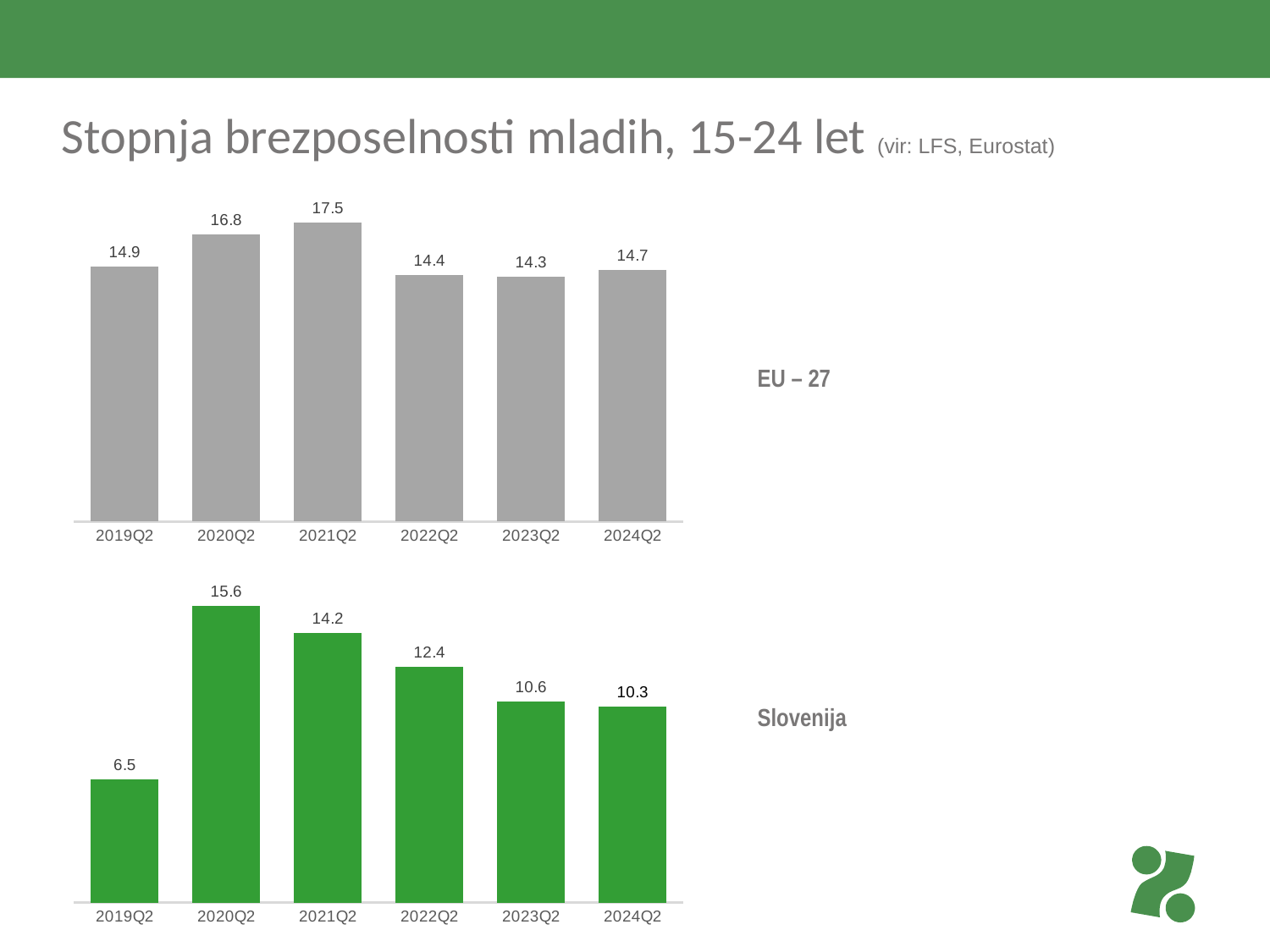
In the Slovenija chart, which quarter has the highest value? 2020Q2 Which is larger: the 2024Q2 value in the EU – 27 chart or the 2024Q2 value in the Slovenija chart? EU – 27 In the Slovenija chart, what is the value for 2019Q2? 6.5 In the EU – 27 chart, what is the value for 2021Q2? 17.5 In the EU – 27 chart, which quarter has the highest value? 2021Q2 In the Slovenija chart, what is the difference between the values for 2020Q2 and 2024Q2? 5.3 What colour are the bars in the Slovenija chart? green How many quarters are shown in the Slovenija chart? 6 In the EU – 27 chart, what is the difference between the values for 2021Q2 and 2023Q2? 3.2 In the Slovenija chart, do the values rise or fall from 2020Q2 to 2024Q2? fall What kind of chart is the EU – 27 chart? bar chart In the Slovenija chart, which quarter has the lowest value? 2019Q2